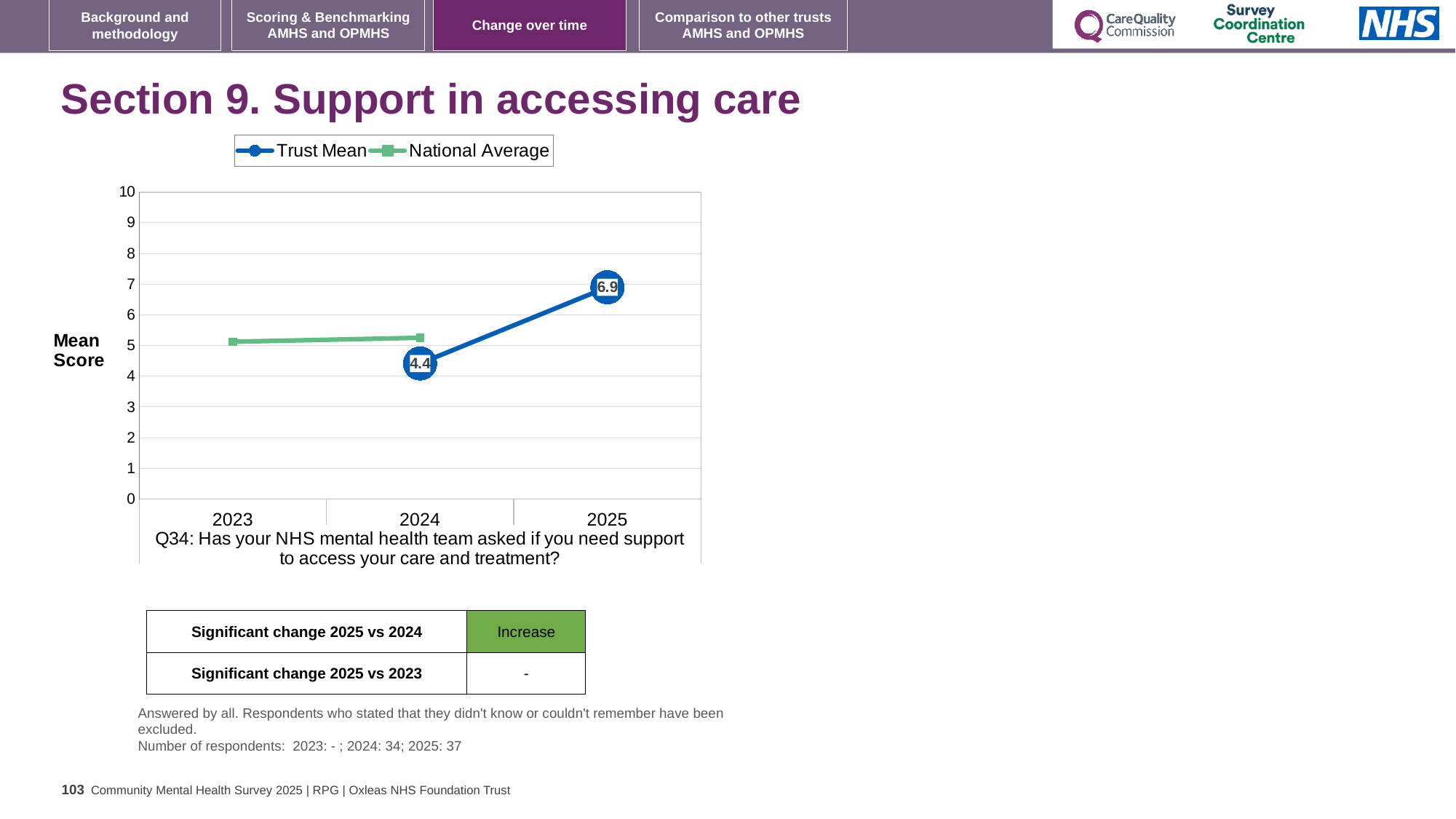
What is the Trust Mean value for 2024? 4.4 Does the Trust Mean rise or fall from 2024 to 2025? rise What kind of chart is shown on the slide? line chart What is the Trust Mean value for 2025? 6.9 What is the difference between the Trust Mean in 2025 and in 2024? 2.5 Which year has the higher Trust Mean, 2024 or 2025? 2025 In 2024, which is larger, the Trust Mean or the National Average? National Average Is the National Average value for 2023 greater or less than 6? less How many years are shown on the x axis? 3 What is the label on the y axis of the chart? Mean Score Is the National Average value for 2024 greater or less than 4? greater How many series does the legend list? 2